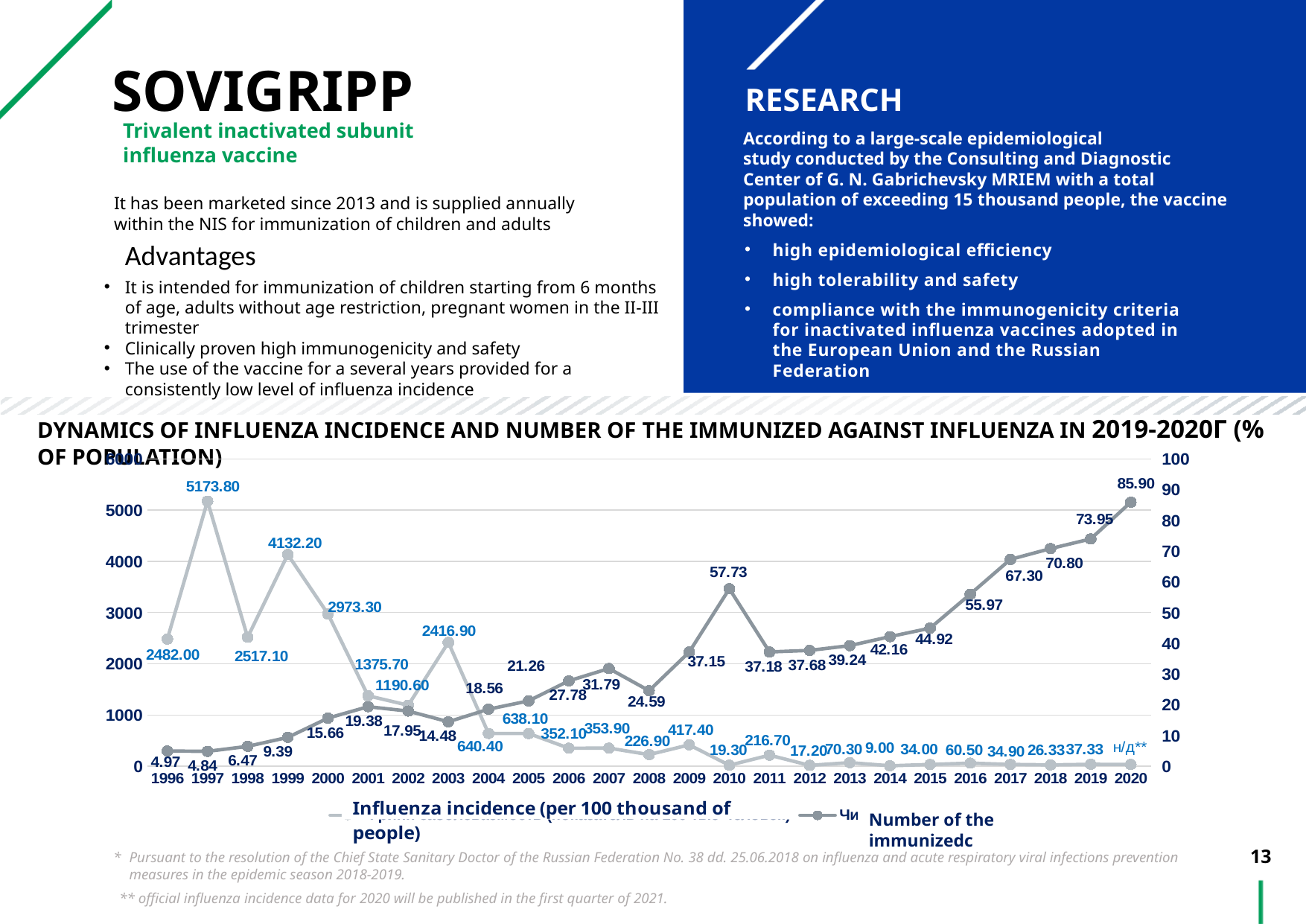
What kind of chart is shown on the slide? line chart What was the influenza incidence (per 100 thousand of people) in 2003? 2416.90 In which year was the number of the immunized lowest? 1997 What was the influenza incidence (per 100 thousand of people) in 1997? 5173.80 How many series does the chart's legend list? 2 What was the number of the immunized (% of population) in 2010? 57.73 How many years are plotted along the x axis of the chart? 25 What was the number of the immunized (% of population) in 2020? 85.90 Which year had the higher influenza incidence, 1999 or 2000? 1999 What is the difference between the number of the immunized in 2020 and in 2019? 11.95 In which year was the influenza incidence highest? 1997 Does the number of the immunized generally rise or fall from 2011 to 2020? rise